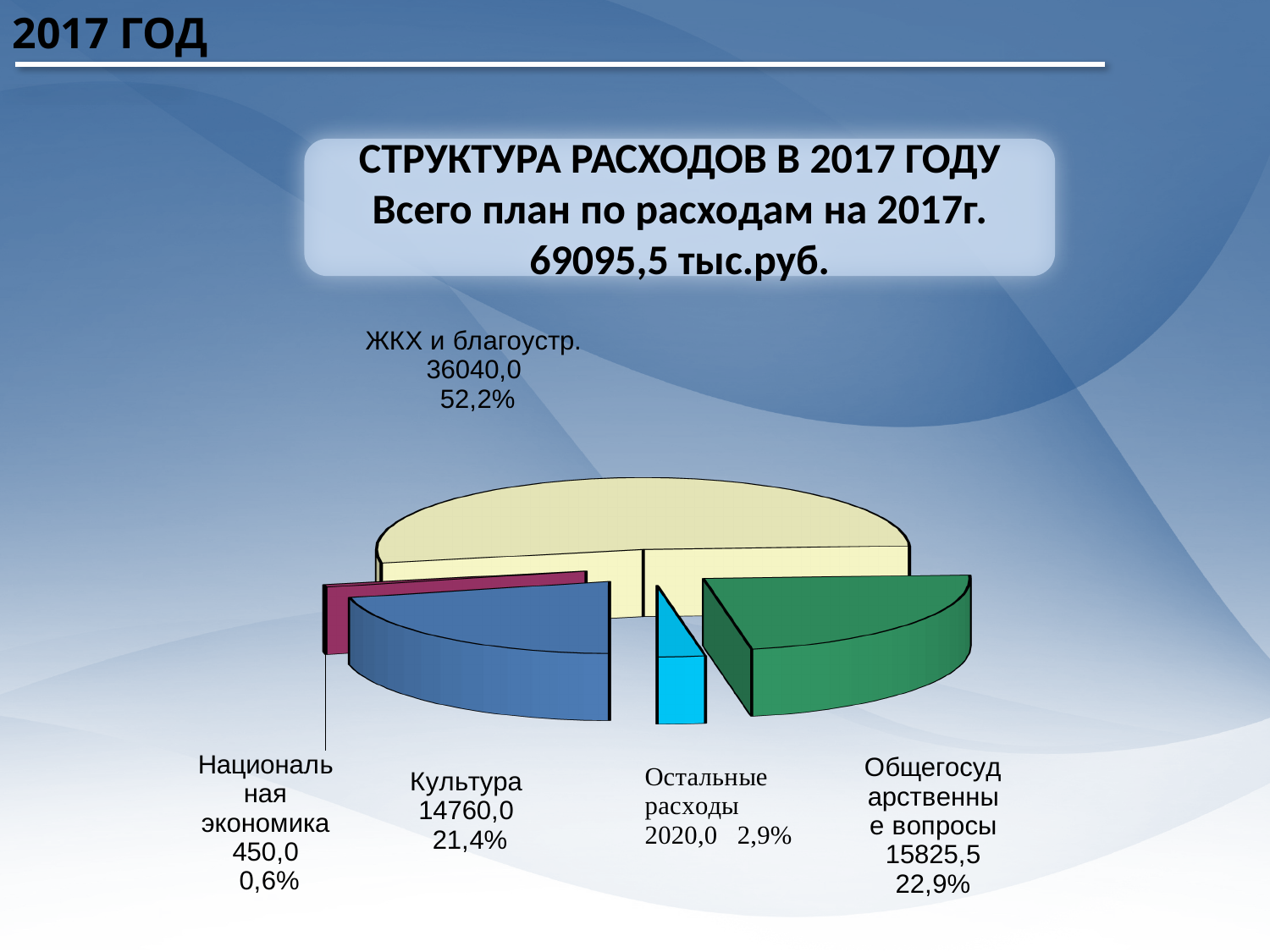
What total planned expenditure for 2017 is stated in the chart title box? 69095,5 тыс.руб. How many slices does the pie chart have? 5 What kind of chart is shown on the slide? Pie chart What is the value for Общегосударственные вопросы? 15825,5 What share of the pie does Остальные расходы take? 2,9% Which category has the smallest slice? Национальная экономика Which is larger, Общегосударственные вопросы or Культура? Общегосударственные вопросы What is the difference between the values for Остальные расходы and Национальная экономика? 1570,0 What is the value for ЖКХ и благоустр.? 36040,0 Which category has the largest slice? ЖКХ и благоустр. What share of the pie does Культура take? 21,4% What is the difference between the values for Общегосударственные вопросы and Культура? 1065,5